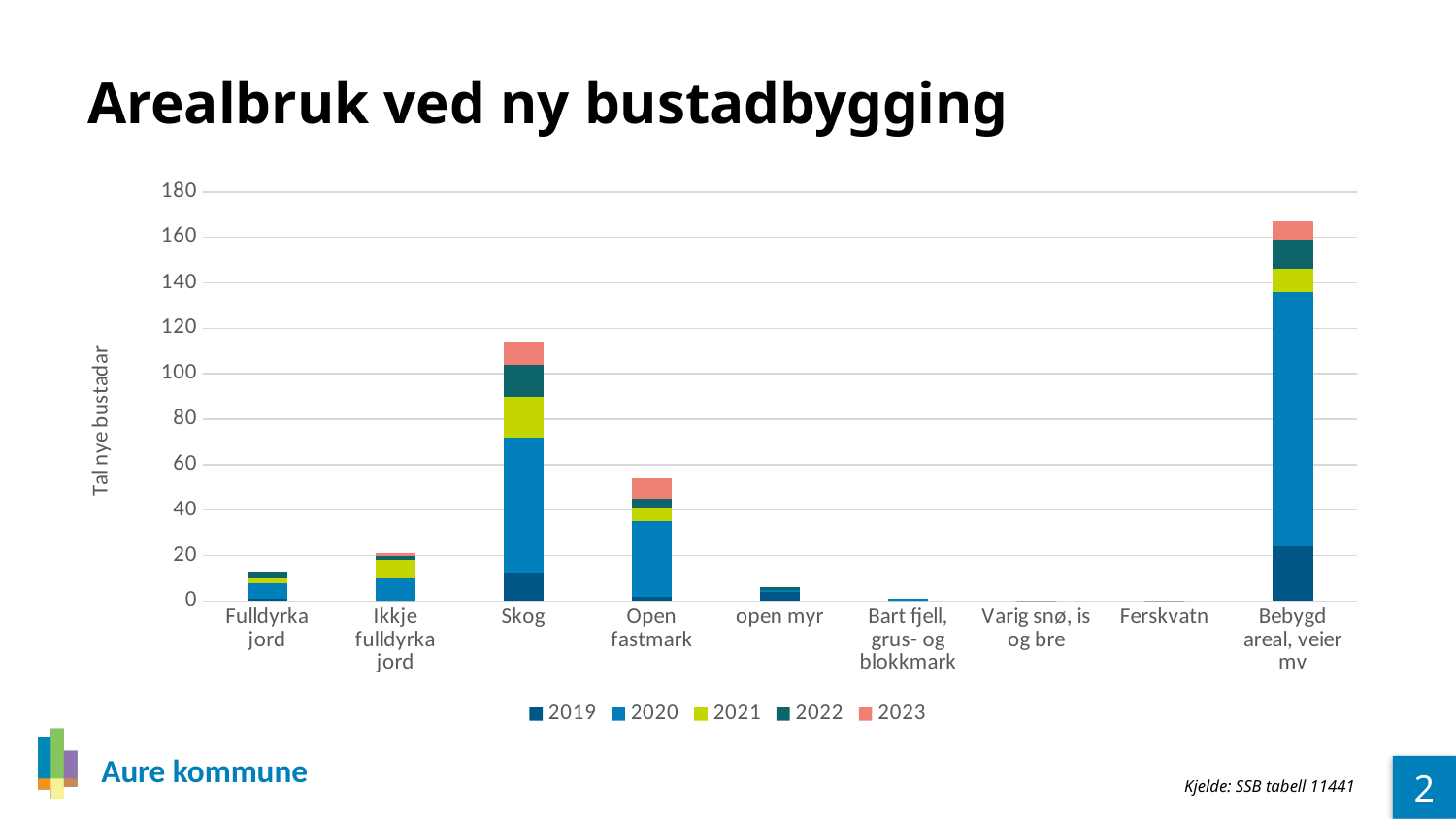
How many series does the legend list? 5 What kind of chart is shown on the slide? Stacked bar chart Is the total stacked value for Skog greater or less than 100? greater What is the title of the chart on the slide? Arealbruk ved ny bustadbygging Which category has the tallest stacked bar? Bebygd areal, veier mv Which has the larger total stacked bar, Skog or Open fastmark? Skog Is the total stacked value for Bebygd areal, veier mv greater or less than 140? greater Which has the larger total stacked bar, Fulldyrka jord or open myr? Fulldyrka jord How many land-use categories are shown along the x axis? 9 What is the label on the y axis? Tal nye bustadar Is the total stacked value for Fulldyrka jord greater or less than 20? less